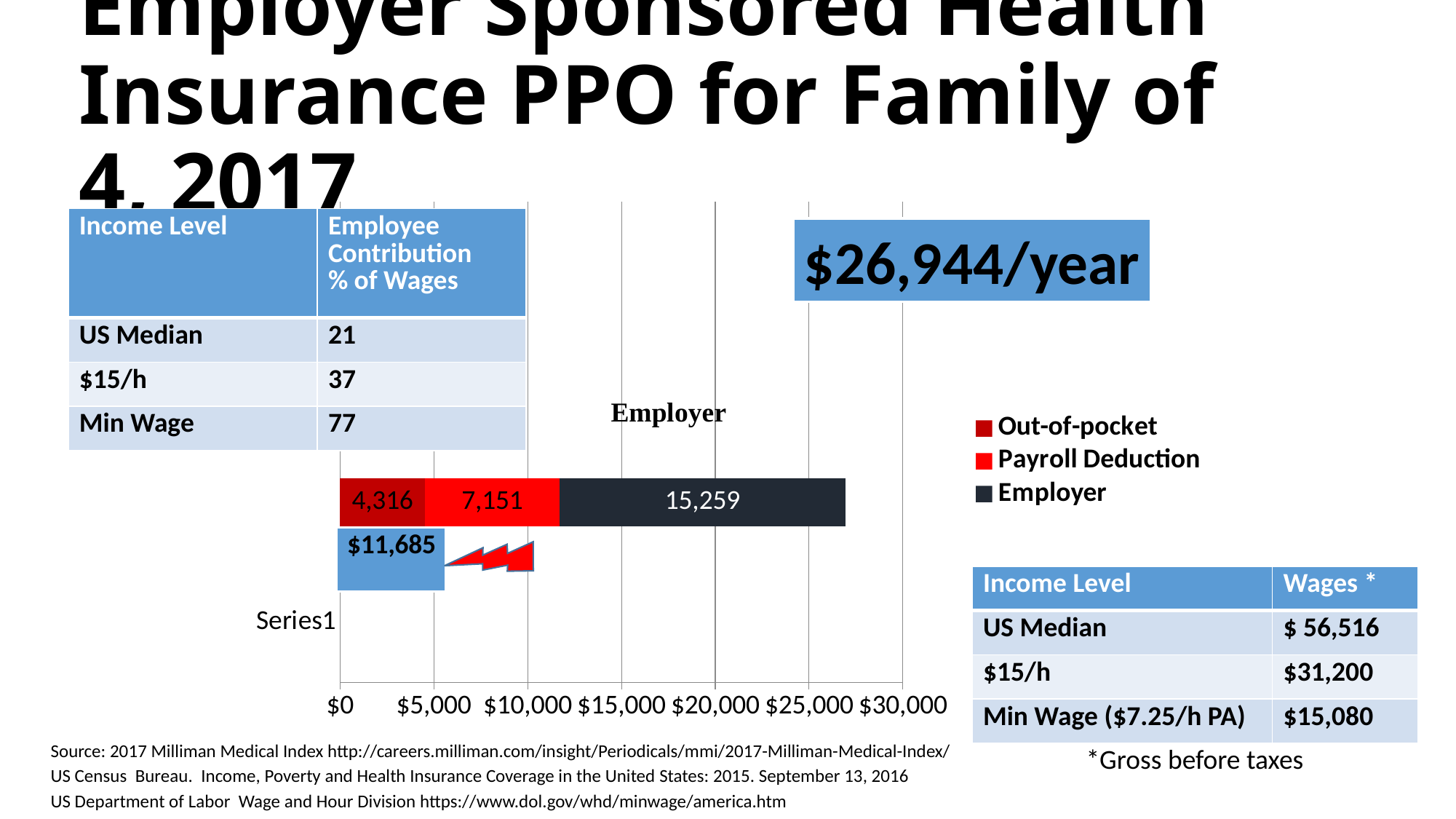
What is the maximum value shown on the chart's x axis? $30,000 How many series does the chart legend list? 3 Which is larger, the Payroll Deduction segment or the Out-of-pocket segment? Payroll Deduction Which series has the largest segment in the stacked bar? Employer Which series has the smallest segment in the stacked bar? Out-of-pocket What is the difference between the Payroll Deduction segment and the Out-of-pocket segment? 2,835 What is the value of the Employer segment in the stacked bar? 15,259 What kind of chart is shown on the slide? Stacked bar chart Is the total length of the stacked bar greater or less than $25,000? greater What is the difference between the Employer segment and the Payroll Deduction segment? 8,108 What is the value of the Payroll Deduction segment in the stacked bar? 7,151 What is the value of the Out-of-pocket segment in the stacked bar? 4,316